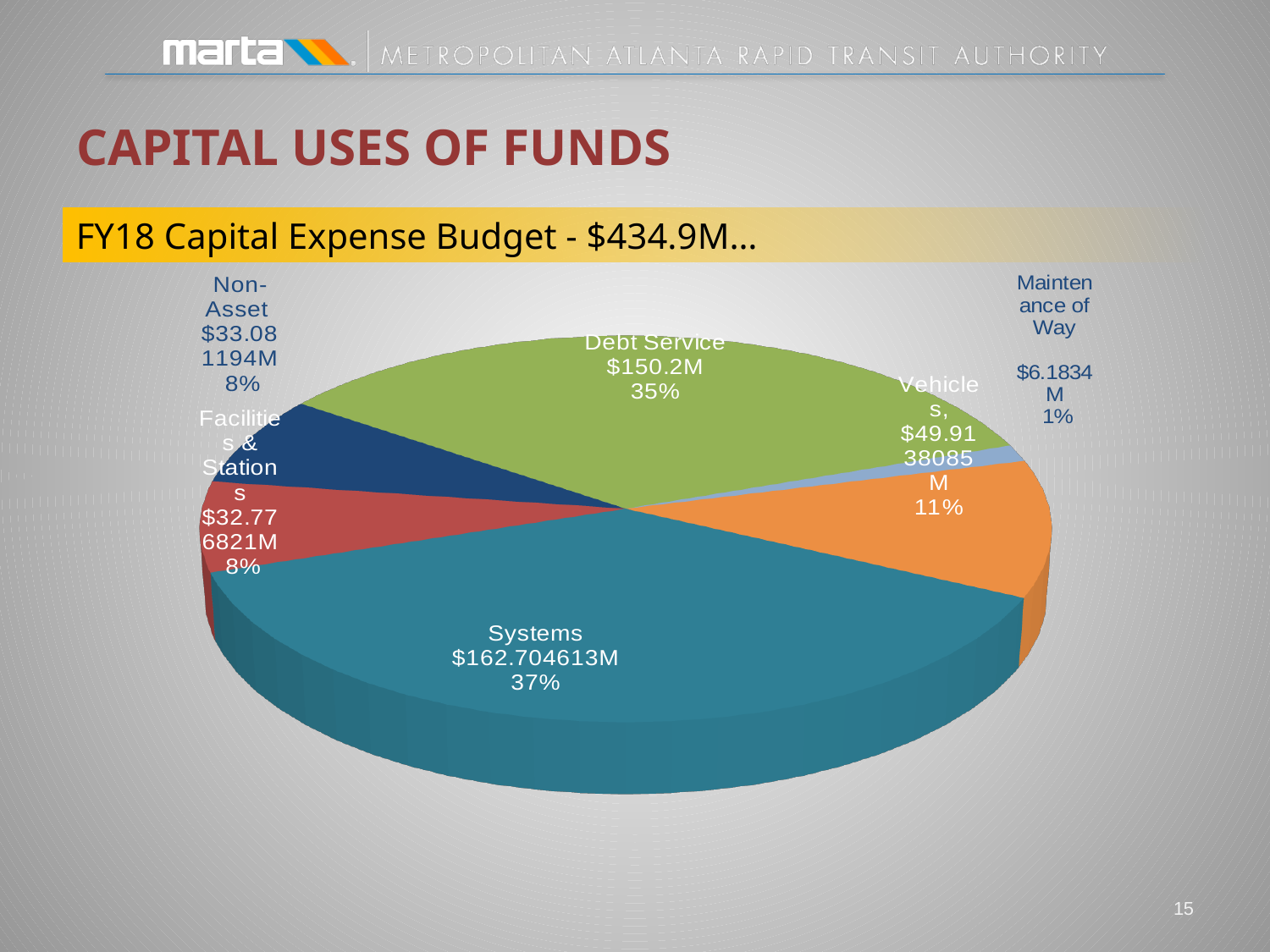
What share of the pie does Debt Service represent? 35% By how many percentage points does the Systems share exceed the Debt Service share? 2 percentage points What is the title shown above the pie chart? FY18 Capital Expense Budget - $434.9M... What share of the pie does Vehicles represent? 11% What is the value shown for Systems? $162.704613M What is the value shown for Debt Service? $150.2M How many slices does the pie chart have? 6 Which is larger, the Debt Service slice or the Vehicles slice? Debt Service Which category has the smallest slice of the pie chart? Maintenance of Way What kind of chart is shown on the slide? Pie chart What is the value shown for Maintenance of Way? $6.1834M Which category has the largest slice of the pie chart? Systems